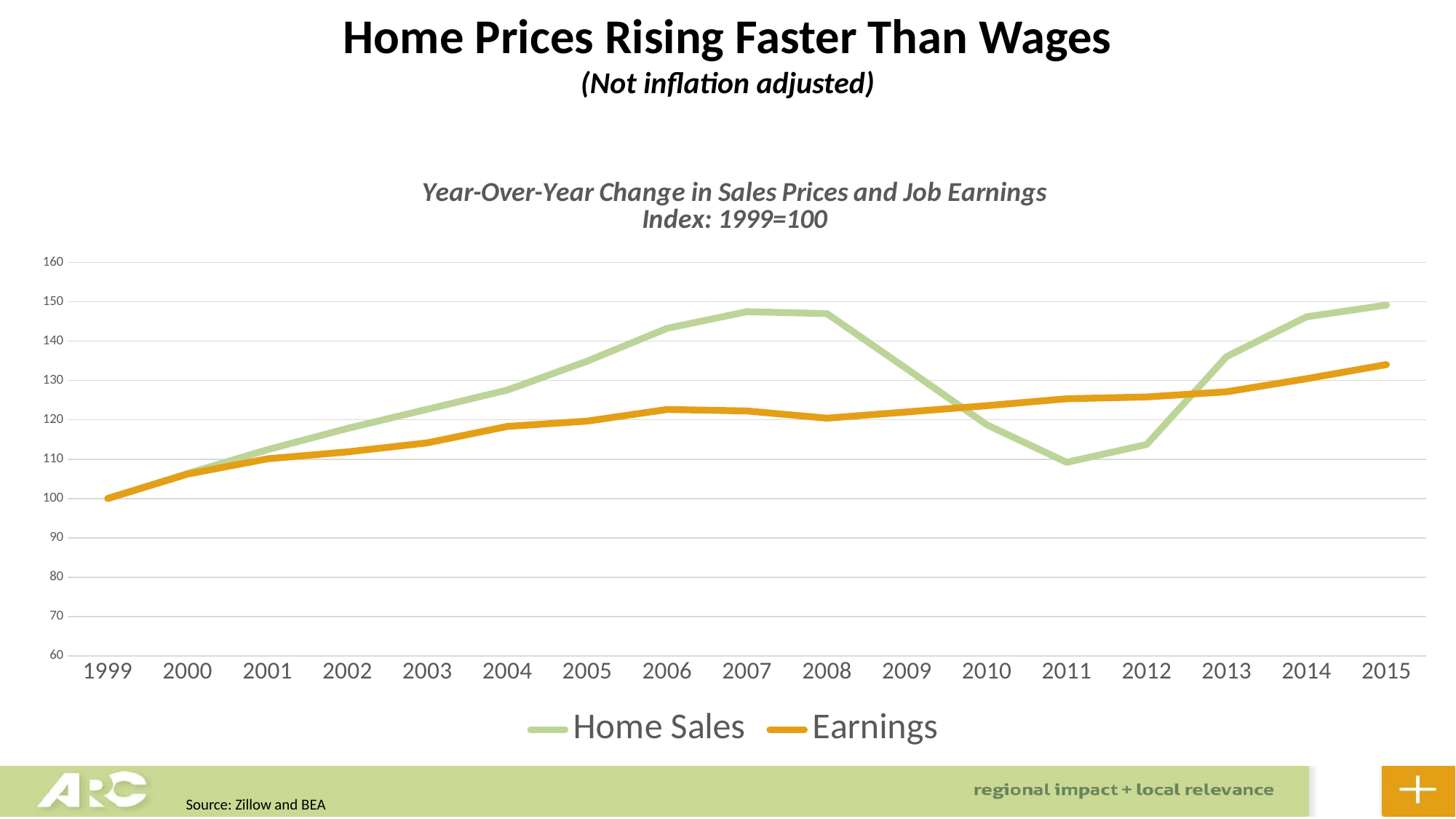
How many years are plotted along the x axis? 17 What is the value of the Home Sales index in 1999? 100 In which year does the Earnings series reach its highest value? 2015 Is the Home Sales value for 2007 greater or less than 140? greater What kind of chart is shown on the slide? line chart Is the Earnings value for 2015 greater or less than 130? greater How many series does the legend list? 2 In 2007, which series has the higher value, Home Sales or Earnings? Home Sales In 2011, which series has the higher value, Home Sales or Earnings? Earnings What is the value of the Earnings index in 1999? 100 Does the Home Sales series rise or fall between 2007 and 2011? fall Is the Home Sales value for 2011 greater or less than 120? less